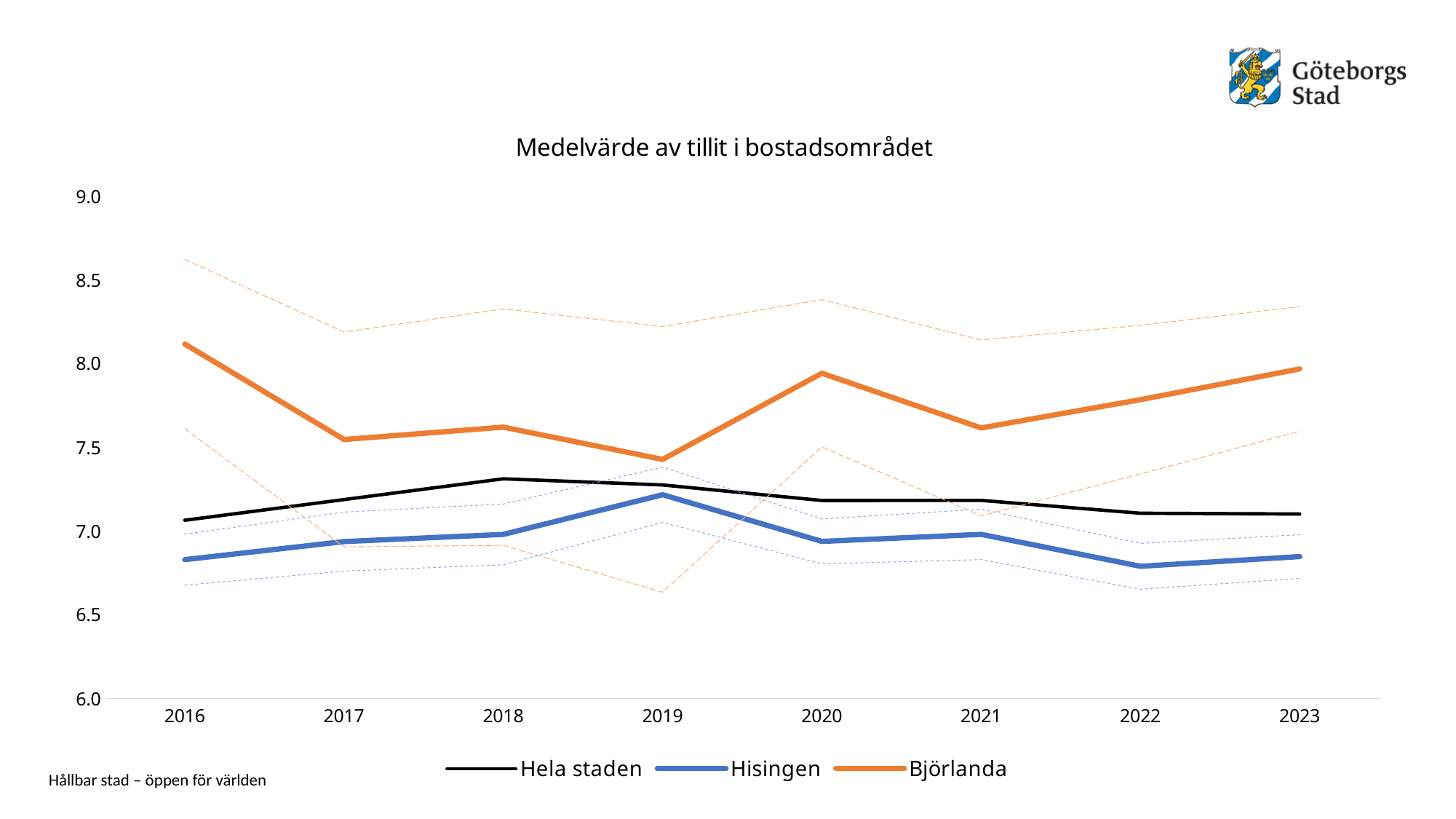
Does the Hisingen line rise or fall from 2019 to 2022? fall How many series does the legend list? 3 Which is higher in 2023, Björlanda or Hisingen? Björlanda Is the value for Björlanda in 2019 greater or less than 7.5? less What is the title of the chart? Medelvärde av tillit i bostadsområdet Which series is drawn in orange? Björlanda In which year is the Hisingen line at its highest? 2019 Is the value for Björlanda in 2016 greater or less than 8.0? greater Is the value for Hisingen in 2022 greater or less than 7.0? less What kind of chart is shown on the slide? line chart How many years are shown on the x axis? 8 In which year is the Björlanda line at its lowest? 2019